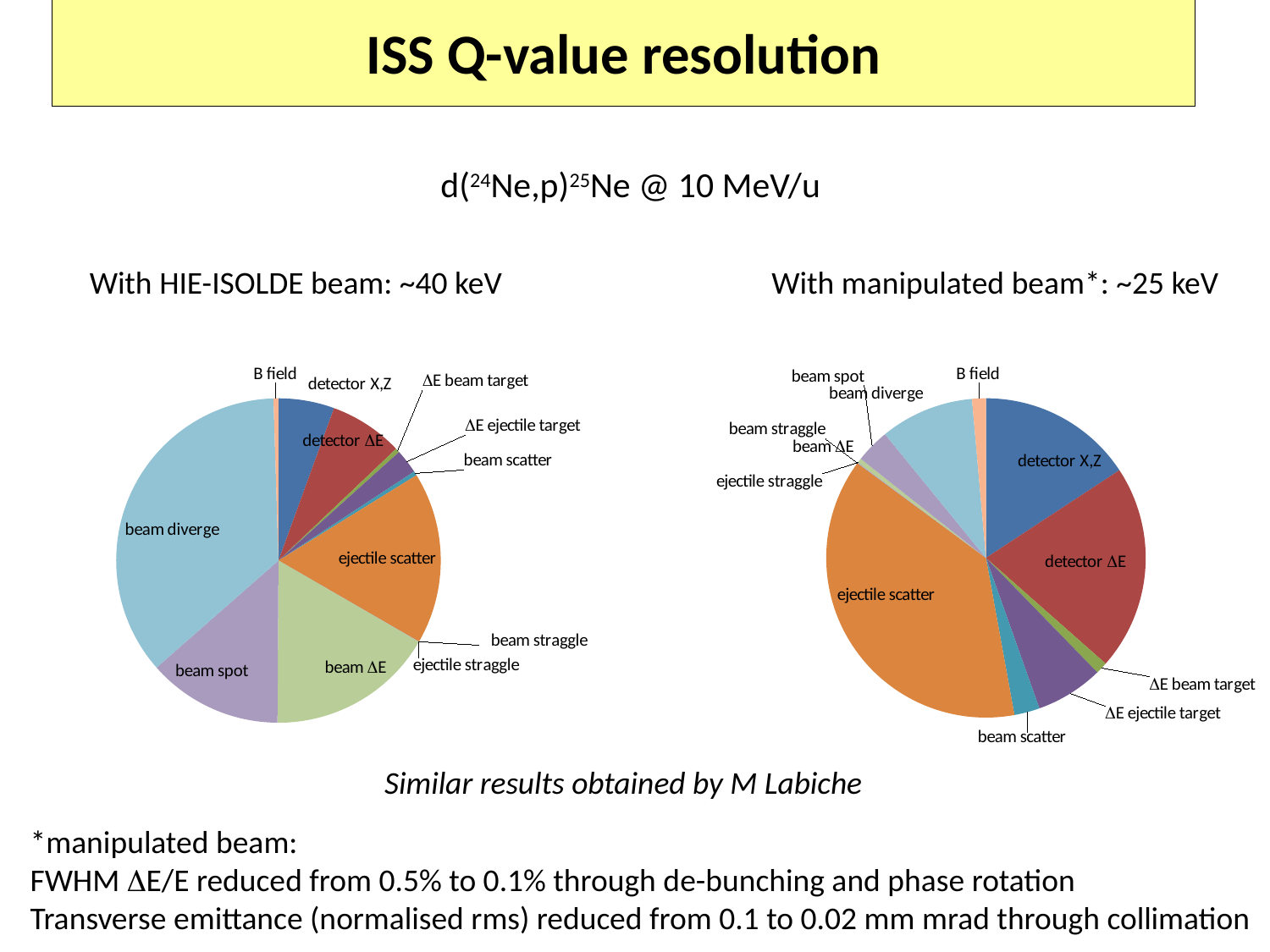
How many slices does the right chart (With manipulated beam*: ~25 keV) have? 12 How many slices does the left chart (With HIE-ISOLDE beam: ~40 keV) have? 12 In the right chart (With manipulated beam*: ~25 keV), which slice is larger: ejectile scatter or detector ΔE? ejectile scatter In the right chart (With manipulated beam*: ~25 keV), which category has the largest slice? ejectile scatter In the left chart (With HIE-ISOLDE beam: ~40 keV), which slice is larger: beam diverge or beam spot? beam diverge In the left chart (With HIE-ISOLDE beam: ~40 keV), which slice is larger: ejectile scatter or beam spot? ejectile scatter What kind of chart is the left chart (With HIE-ISOLDE beam: ~40 keV)? pie chart How many pie charts are shown on the slide? 2 What is the heading above the right pie chart? With manipulated beam*: ~25 keV What kind of chart is the right chart (With manipulated beam*: ~25 keV)? pie chart In the left chart (With HIE-ISOLDE beam: ~40 keV), which category has the largest slice? beam diverge